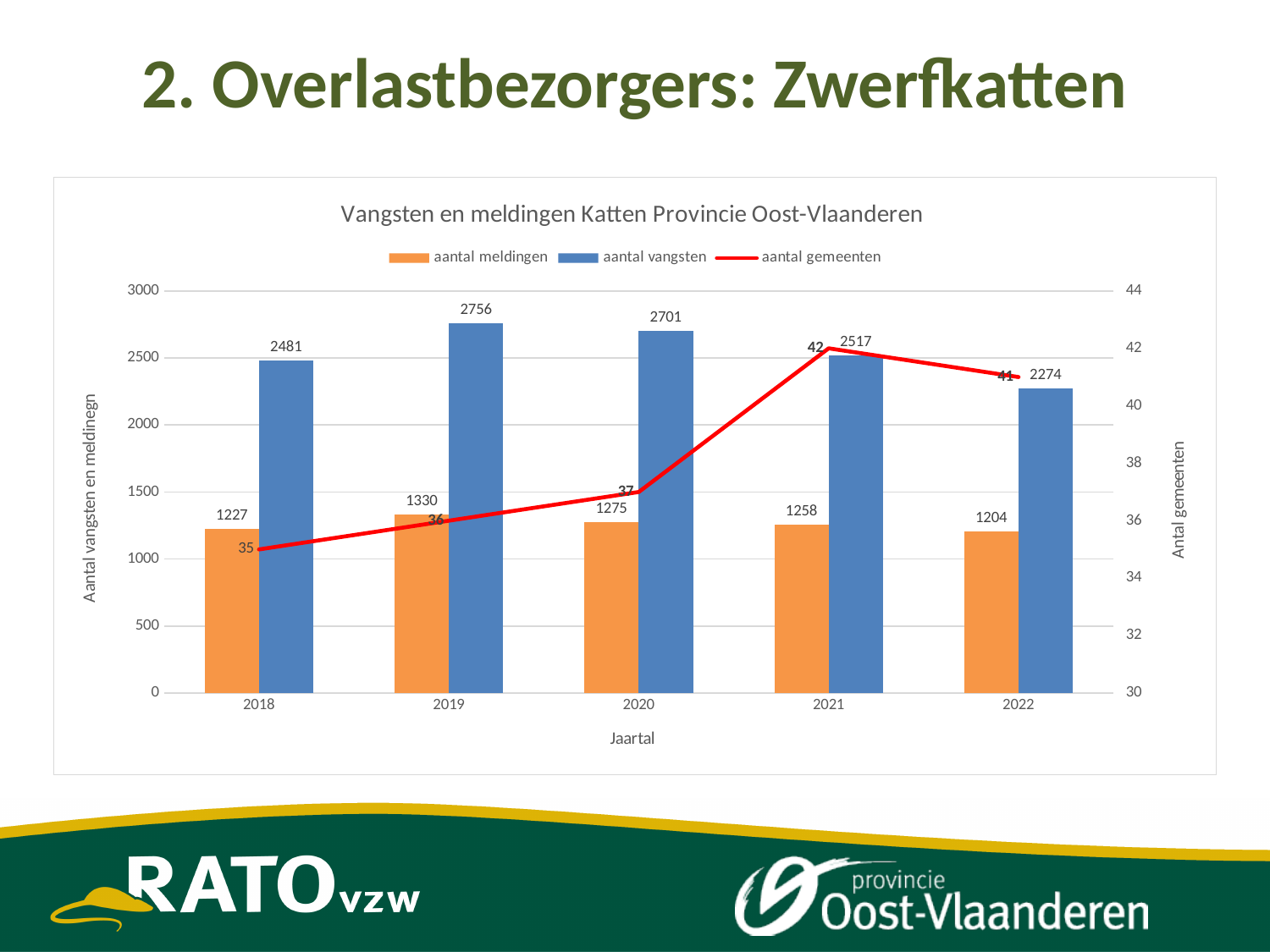
Which year has the highest aantal vangsten? 2019 What is the title of the chart? Vangsten en meldingen Katten Provincie Oost-Vlaanderen What is the value of aantal gemeenten for 2021? 42 How many series does the legend list? 3 What is the difference between aantal vangsten in 2019 and 2022? 482 Which year has the lowest aantal meldingen? 2022 What is the value of aantal meldingen for 2022? 1204 Is the value of aantal vangsten for 2018 greater or less than 2500? less What is the value of aantal vangsten for 2019? 2756 Which is larger, aantal meldingen in 2019 or in 2020? 2019 How many years are shown on the x axis? 5 Does aantal gemeenten rise or fall from 2018 to 2021? rise